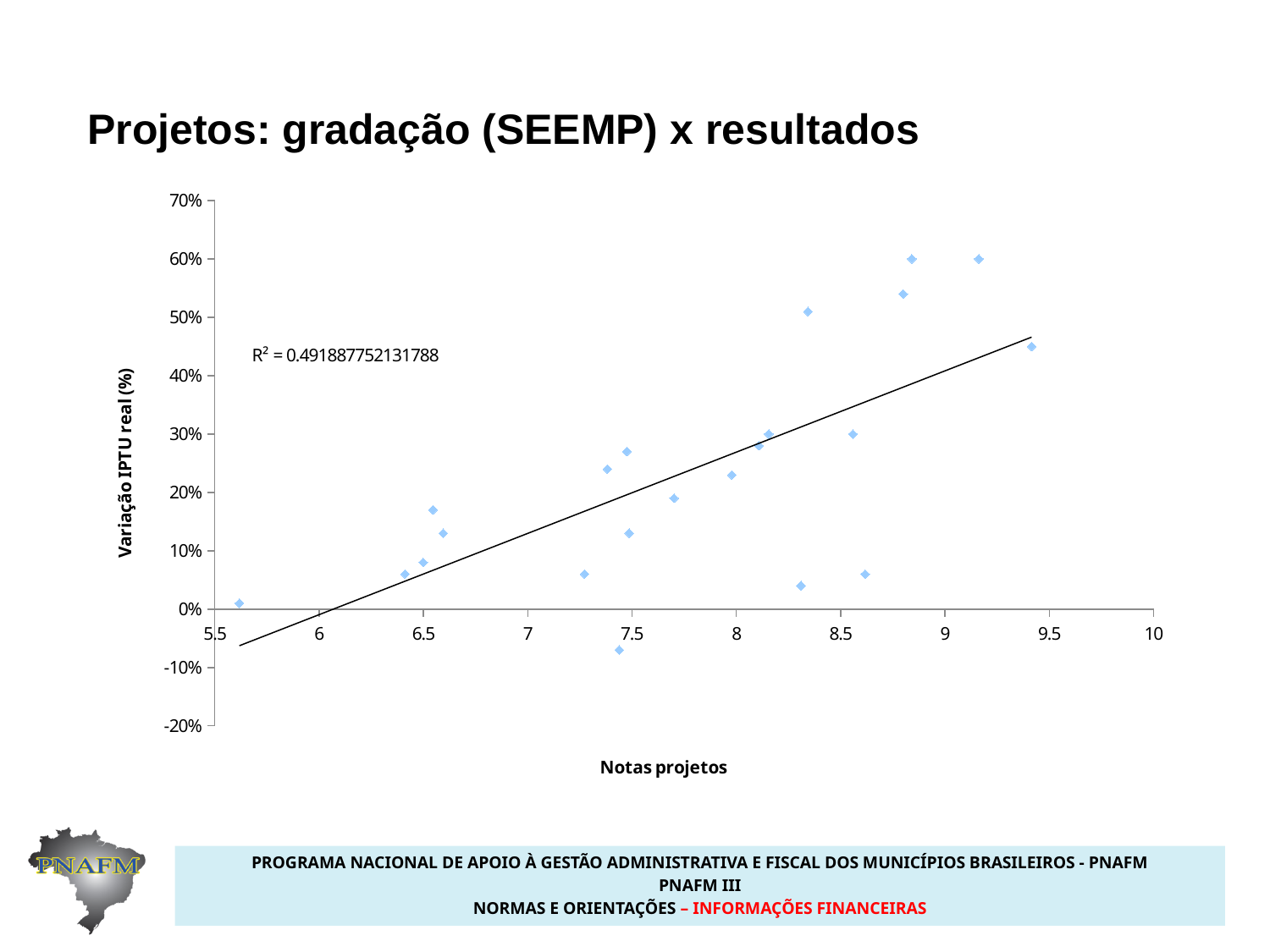
Is the value of the rightmost plotted point (near 9.4 on the x-axis) greater or less than 40%? greater What is the R² value printed on the chart? 0.491887752131788 Is the value of the leftmost plotted point (near 5.6 on the x-axis) greater or less than 10%? less What is the label of the vertical axis? Variação IPTU real (%) What is the title of the chart? Projetos: gradação (SEEMP) x resultados Is the R² value of the trendline greater or less than 0.5? less Does the trendline rise or fall as the x-axis values (Notas projetos) increase? rise How many plotted points lie below 0% on the vertical axis? 1 What is the highest value shown on the vertical axis? 70% What kind of chart is shown on the slide? scatter chart